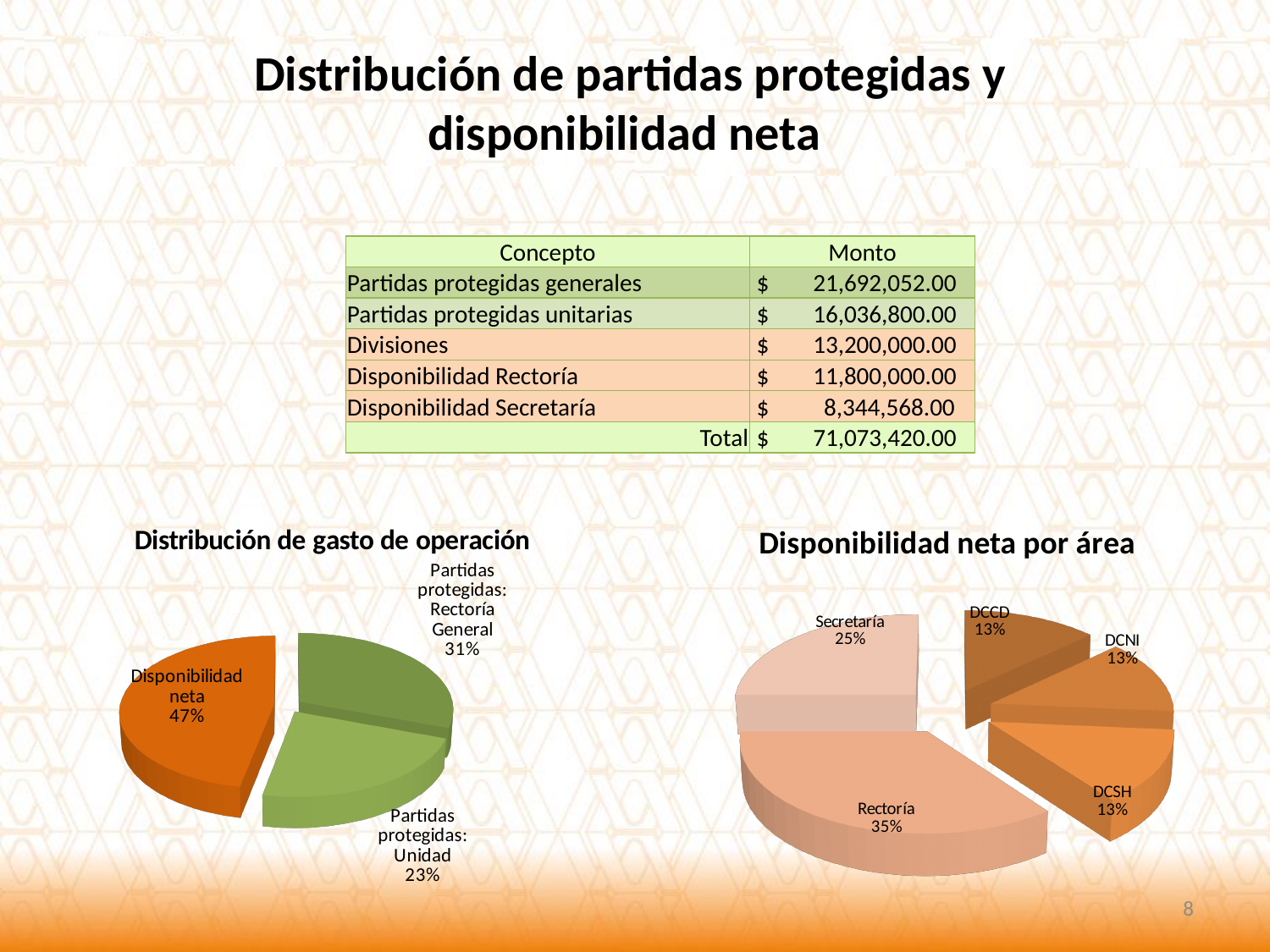
In the 'Distribución de gasto de operación' chart, what share does 'Partidas protegidas: Rectoría General' have? 31% In the 'Distribución de gasto de operación' chart, which slice is the smallest? Partidas protegidas: Unidad In the 'Disponibilidad neta por área' chart, how many areas are shown? 5 In the 'Disponibilidad neta por área' chart, which area has the largest share? Rectoría In the 'Distribución de gasto de operación' chart, which slice is the largest? Disponibilidad neta In the 'Distribución de gasto de operación' chart, what share does 'Partidas protegidas: Unidad' have? 23% In the 'Distribución de gasto de operación' chart, what share does 'Disponibilidad neta' have? 47% What kind of chart is 'Disponibilidad neta por área'? Pie chart In the 'Disponibilidad neta por área' chart, what is the difference in percentage points between 'Rectoría' and 'Secretaría'? 10 percentage points In the 'Distribución de gasto de operación' chart, how many slices are there? 3